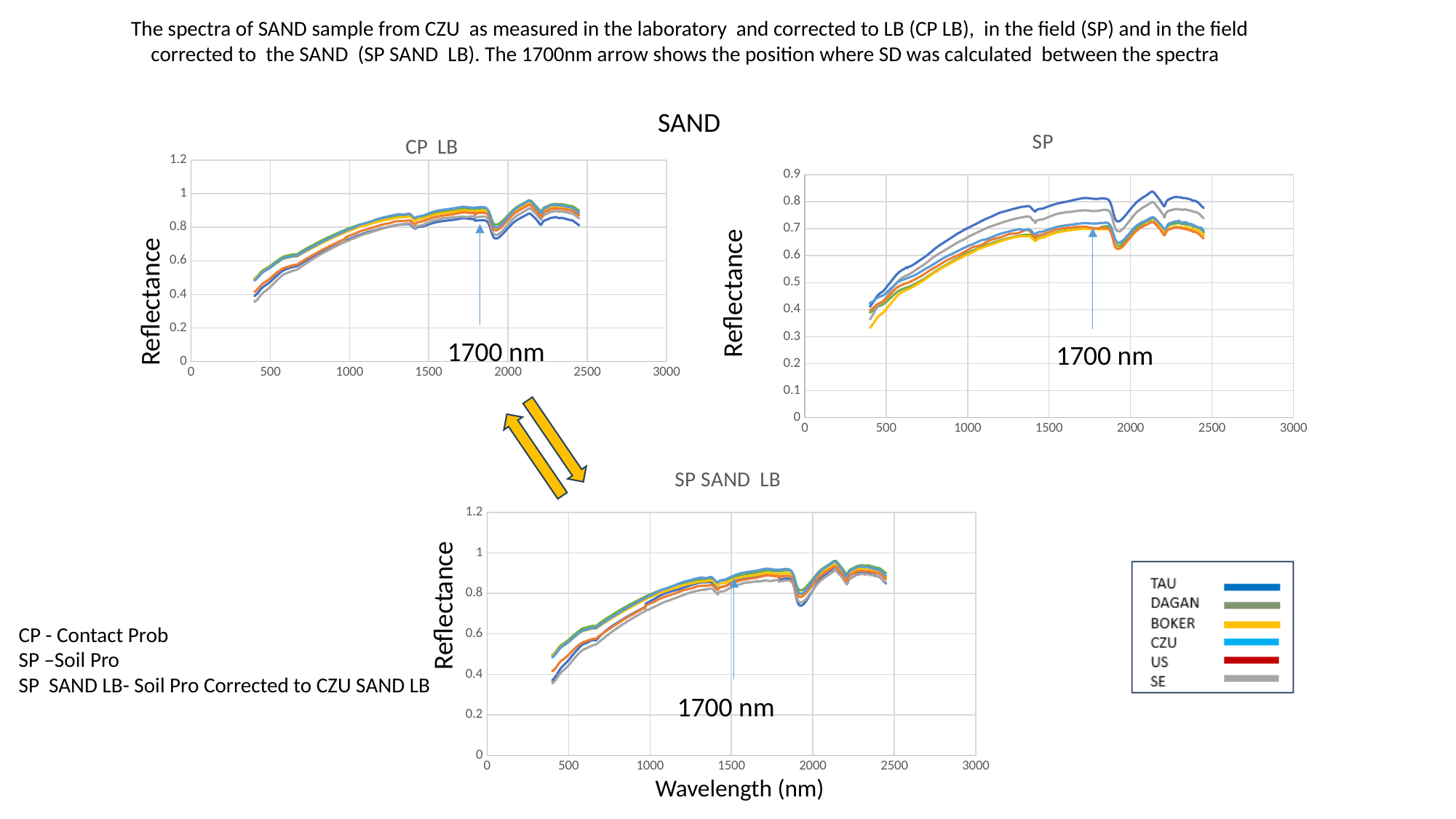
What wavelength does the arrow in each chart mark? 1700 nm In the SP SAND LB chart, is the reflectance of the SE series at 1000 nm greater or less than 0.6? greater In the SP chart, which series has the highest reflectance at 2000 nm? TAU What kind of chart is the CP LB chart? line chart How many charts are shown on the slide? 3 In the SP chart, is the reflectance of the TAU series at 2000 nm greater or less than 0.7? greater In the SP chart, is the reflectance of the BOKER series at 500 nm greater or less than 0.5? less How many series does the legend list? 6 What is the highest value shown on the y axis of the SP chart? 0.9 In the SP chart, do the reflectance values rise or fall between 500 nm and 1500 nm? rise